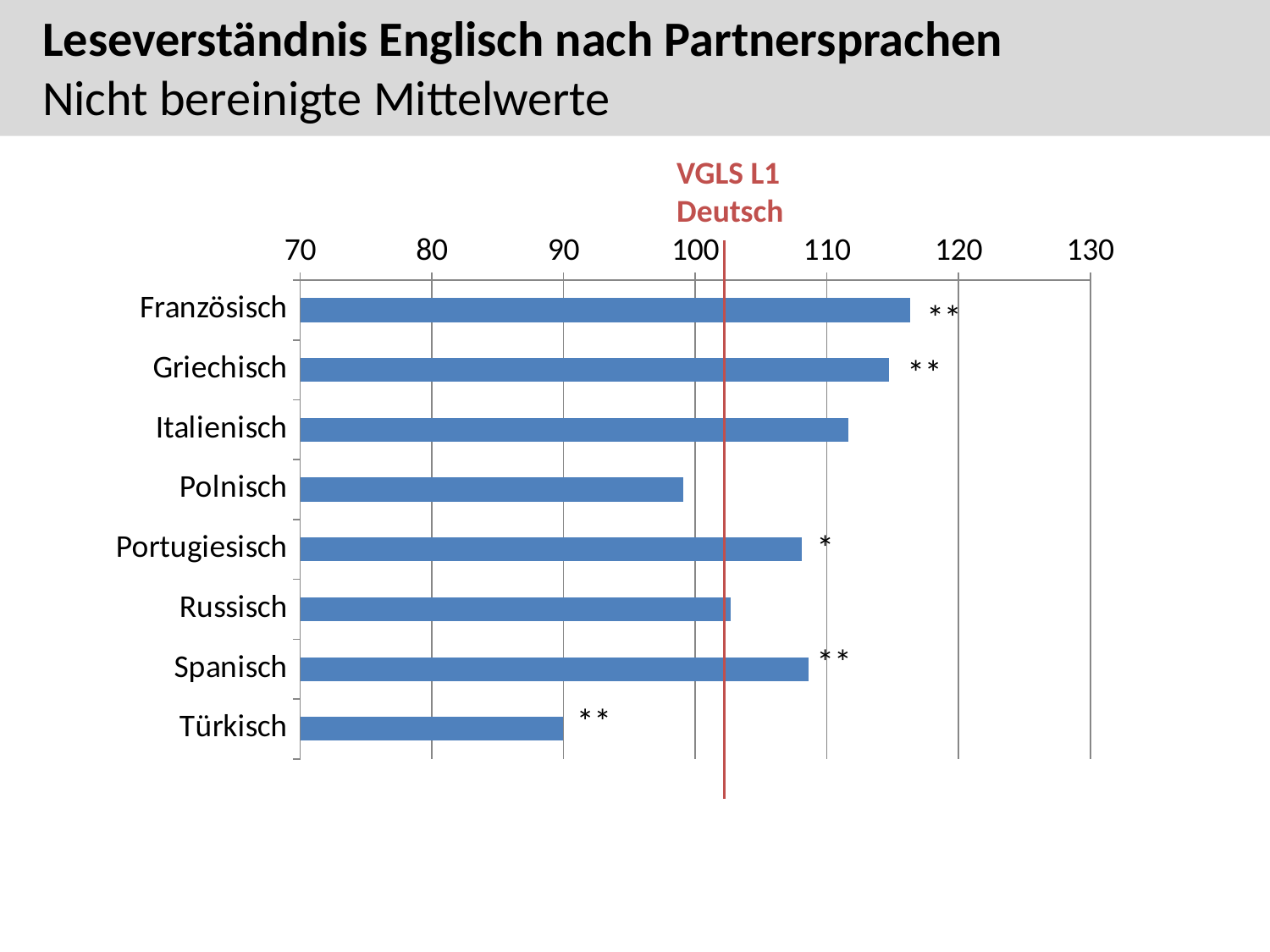
Which has the larger value, Italienisch or Polnisch? Italienisch What is the label of the red vertical reference line in the chart? VGLS L1 Deutsch Which has the larger value, Russisch or Spanisch? Spanisch What is the title of the slide? Leseverständnis Englisch nach Partnersprachen How many partner languages (categories) are plotted in the chart? 8 Is the value for Französisch greater or less than 120? less Is the value for Polnisch greater or less than 100? less What kind of chart is shown on the slide? bar chart Is the value for Italienisch greater or less than 110? greater Which partner language has the highest value in the chart? Französisch Which partner language has the lowest value in the chart? Türkisch